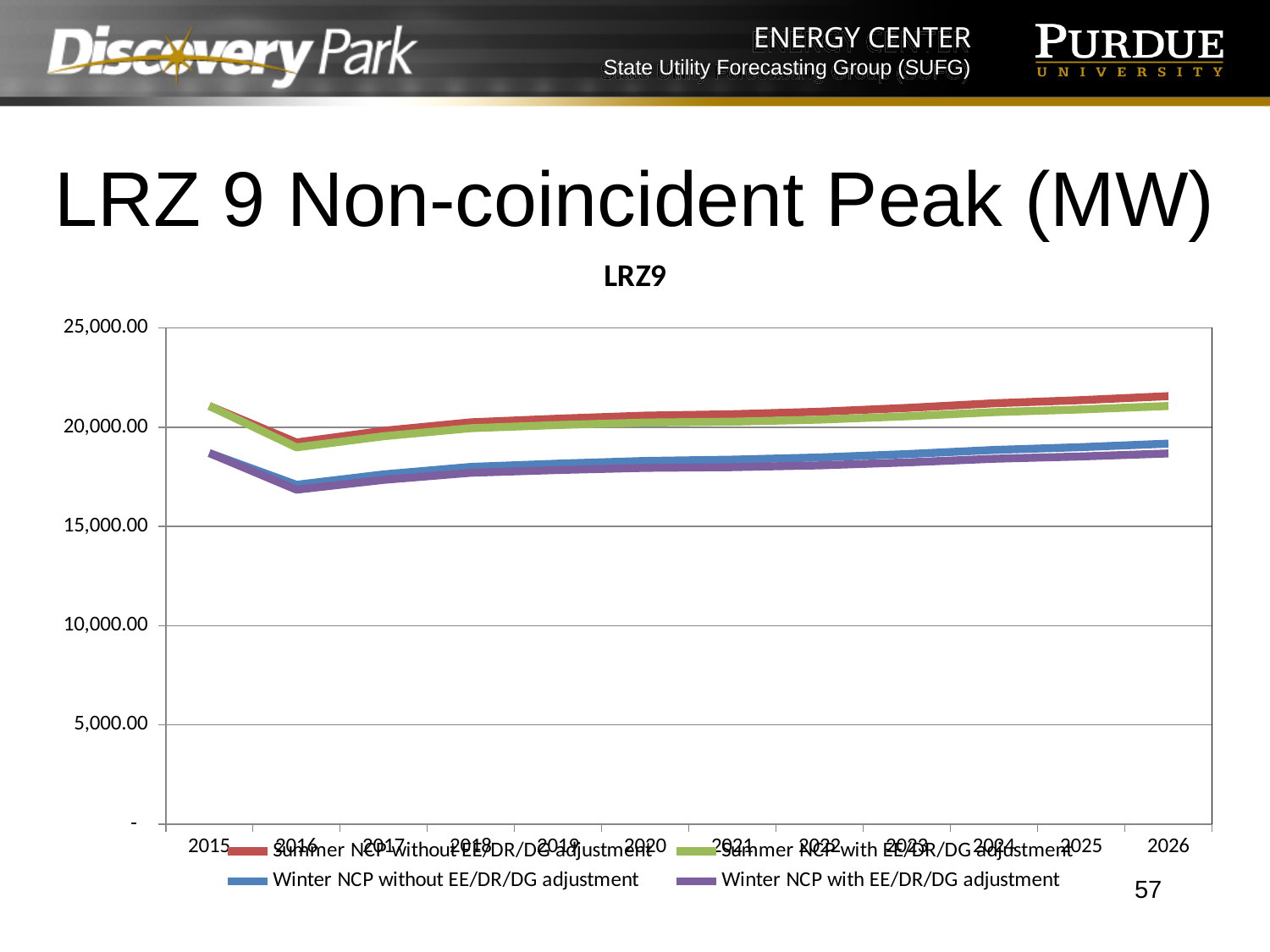
Is the value for Winter NCP with EE/DR/DG adjustment in 2026 greater or less than 15,000.00? greater Is the value for Winter NCP without EE/DR/DG adjustment in 2016 greater or less than 20,000.00? less Which series is drawn in red in the chart? Summer NCP without EE/DR/DG adjustment What is the title shown above the chart's plot area? LRZ9 How many series does the chart legend list? 4 Is the value for Summer NCP with EE/DR/DG adjustment in 2026 greater or less than 25,000.00? less What kind of chart is shown on the slide? line chart Do the values for Summer NCP without EE/DR/DG adjustment rise or fall from 2016 to 2026? rise Do the values for Winter NCP with EE/DR/DG adjustment rise or fall from 2015 to 2016? fall How many years are plotted along the x axis of the chart? 12 In 2020, which is larger: Summer NCP without EE/DR/DG adjustment or Winter NCP without EE/DR/DG adjustment? Summer NCP without EE/DR/DG adjustment